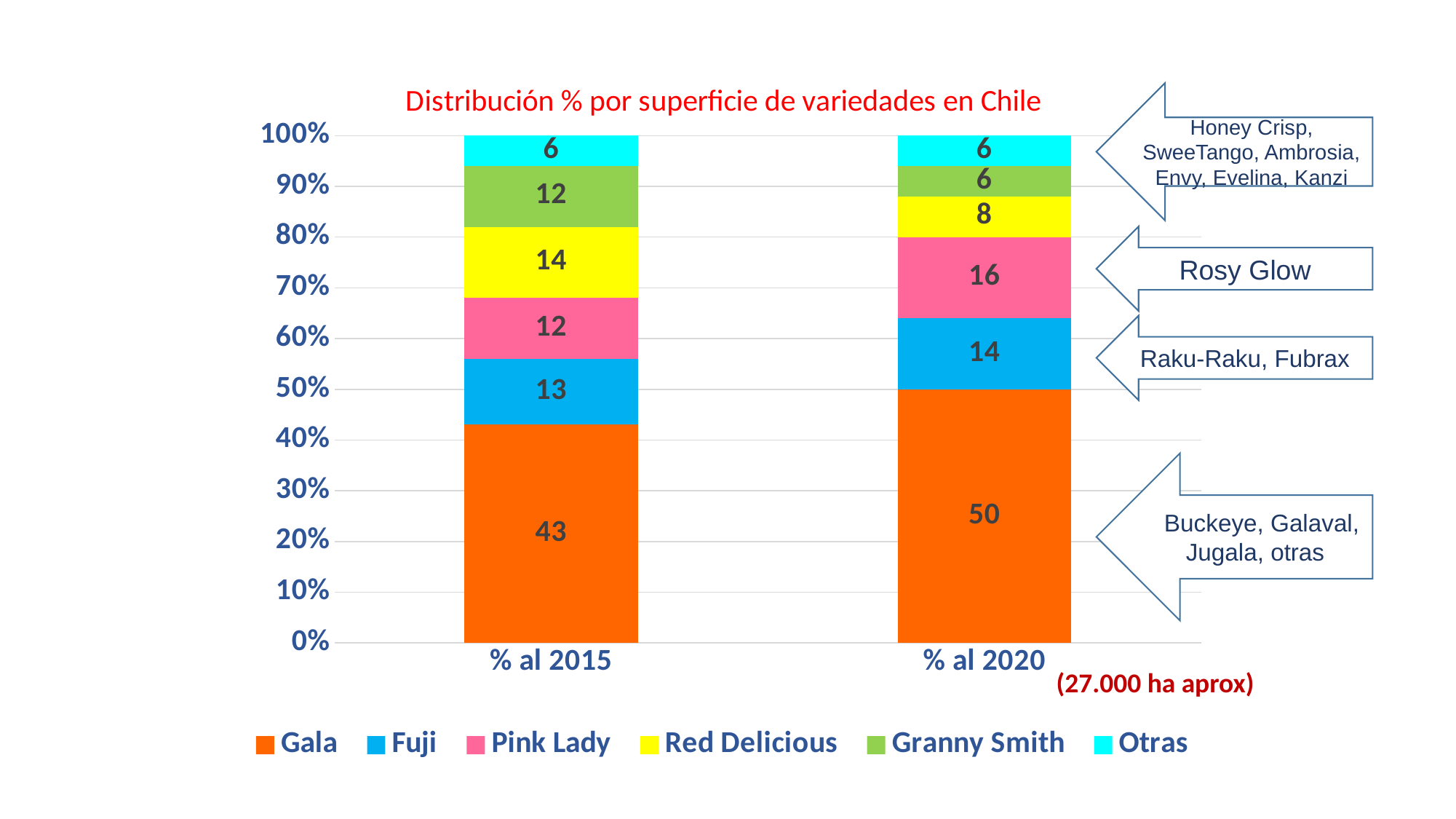
What is the value for Pink Lady in the % al 2020 bar? 16 Which series has the largest segment in the % al 2020 bar? Gala Which is larger, the Red Delicious value in % al 2015 or in % al 2020? % al 2015 What is the difference between the Gala values for % al 2020 and % al 2015? 7 What is the value for Red Delicious in the % al 2015 bar? 14 How many series does the legend list? 6 What kind of chart is shown on the slide? Stacked bar chart What is the value for Gala in the % al 2015 bar? 43 What is the value for Gala in the % al 2020 bar? 50 Which series has the smallest segment in the % al 2015 bar? Otras What is the title of the chart? Distribución % por superficie de variedades en Chile What is the value for Granny Smith in the % al 2020 bar? 6